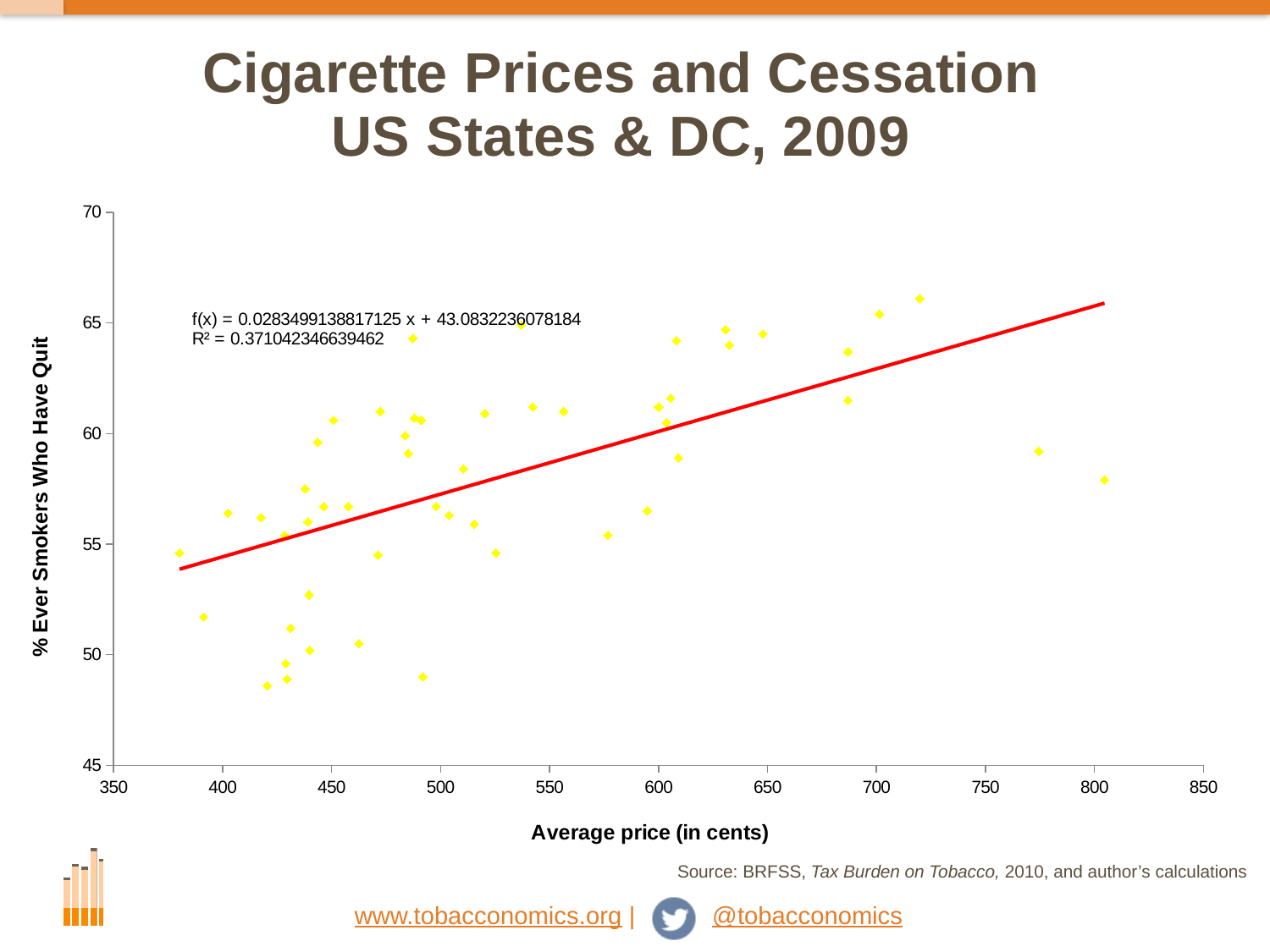
What is the lowest tick value shown on the y axis? 45 What is the title of the chart? Cigarette Prices and Cessation US States & DC, 2009 Do the values for % Ever Smokers Who Have Quit generally rise or fall as average price increases along the x axis? rise Is the highest % Ever Smokers Who Have Quit plotted on the chart greater or less than 65? greater What R² value is printed on the chart? 0.371042346639462 Is the lowest % Ever Smokers Who Have Quit plotted on the chart greater or less than 50? less What is the highest tick value shown on the x axis? 850 What is the label of the x axis? Average price (in cents) Is the % Ever Smokers Who Have Quit for the point with the highest average price greater or less than 55? greater What kind of chart is shown on the slide? scatter plot What is the fitted line equation printed on the chart? f(x) = 0.0283499138817125 x + 43.0832236078184